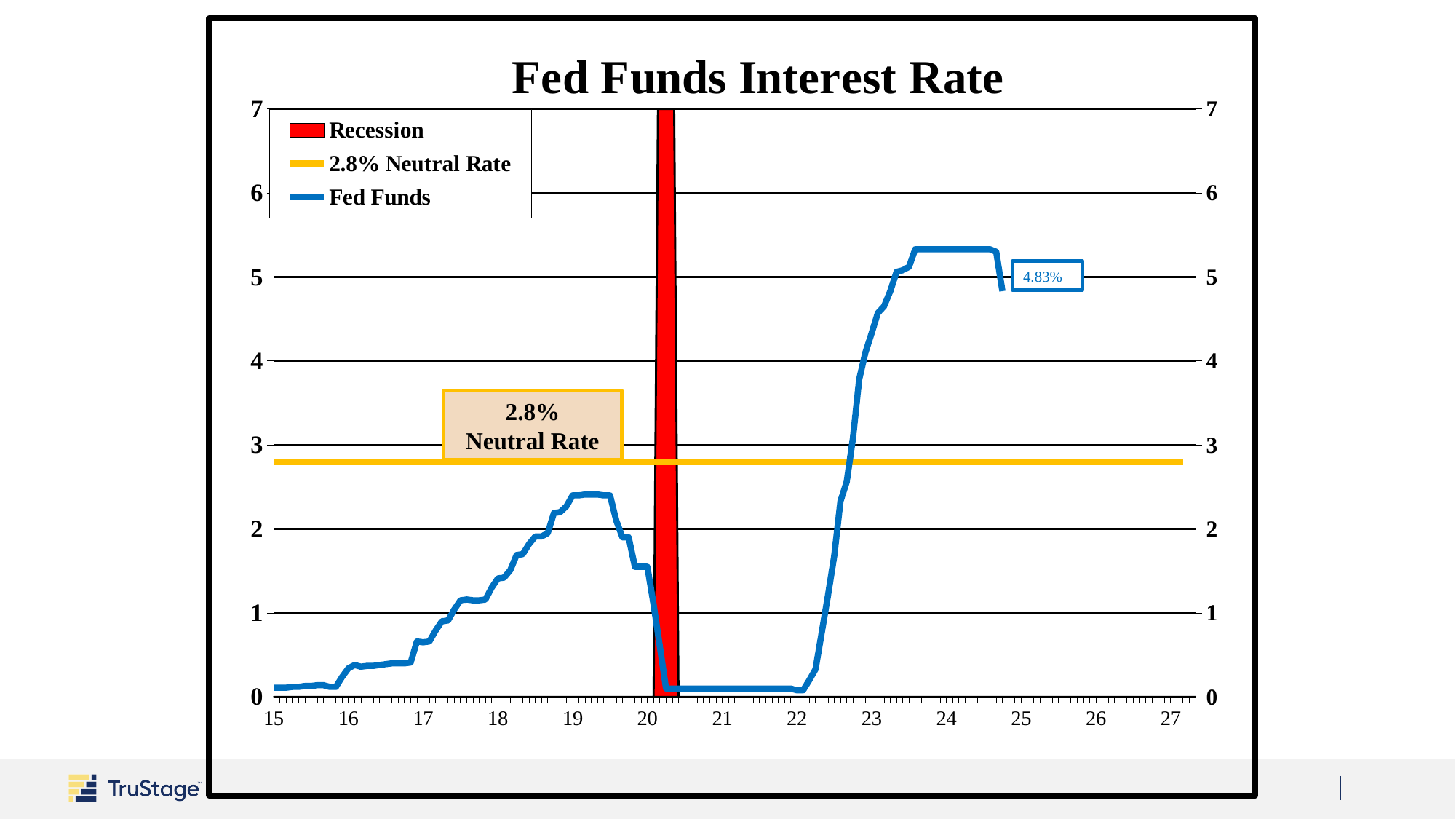
Is the Fed Funds rate in 2021 greater or less than 1? less Does the Fed Funds rate rise or fall between 2022 and 2023? rise Does the Fed Funds rate rise or fall between 2019 and 2020? fall What colour is the Recession series in the legend? red Is the Fed Funds rate at the start of 2019 greater or less than 2? greater Which is higher: the Fed Funds rate in 2024 or the 2.8% neutral rate? Fed Funds rate in 2024 What kind of chart is shown on the slide? line chart How many series does the legend list? 3 What is the value of the neutral rate shown on the chart? 2.8% Is the Fed Funds rate at the start of 2024 greater or less than 5? greater What is the most recent Fed Funds value labelled on the chart? 4.83% What is the title of the chart? Fed Funds Interest Rate